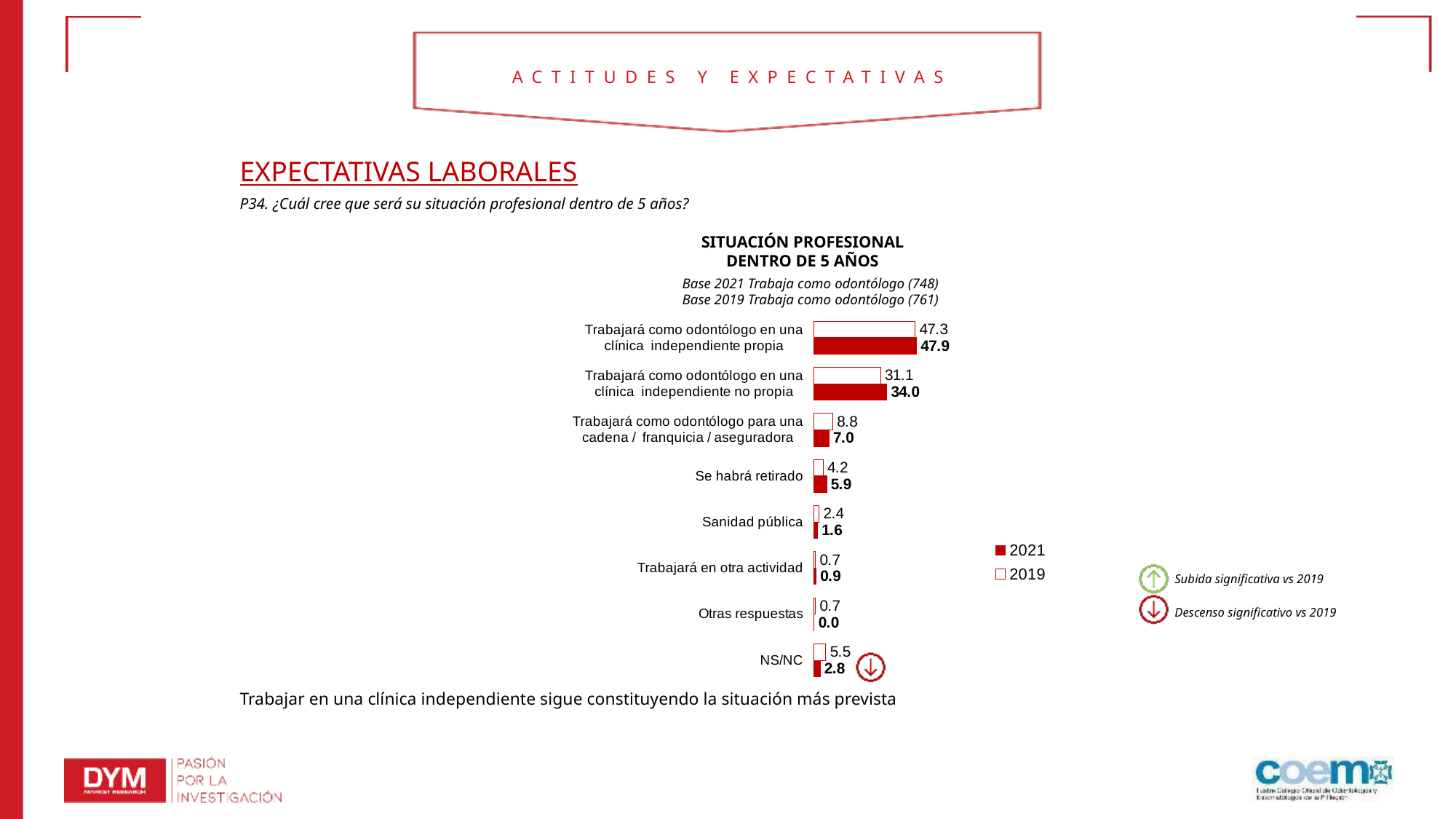
What type of chart is shown on the slide? Bar chart How many series does the legend list? 2 Which category has the lowest 2021 value? Otras respuestas What is the title of the chart? SITUACIÓN PROFESIONAL DENTRO DE 5 AÑOS What is the 2021 value for 'Trabajará como odontólogo en una clínica independiente propia'? 47.9 How many categories are shown in the chart? 8 What is the difference between the 2021 and 2019 values for 'Trabajará como odontólogo en una clínica independiente no propia'? 2.9 What is the 2019 value for 'NS/NC'? 5.5 Which is larger for 'Trabajará como odontólogo para una cadena / franquicia / aseguradora': the 2019 value or the 2021 value? 2019 What is the 2019 value for 'Trabajará como odontólogo en una clínica independiente no propia'? 31.1 Which category has the highest 2021 value? Trabajará como odontólogo en una clínica independiente propia What is the 2021 value for 'Se habrá retirado'? 5.9